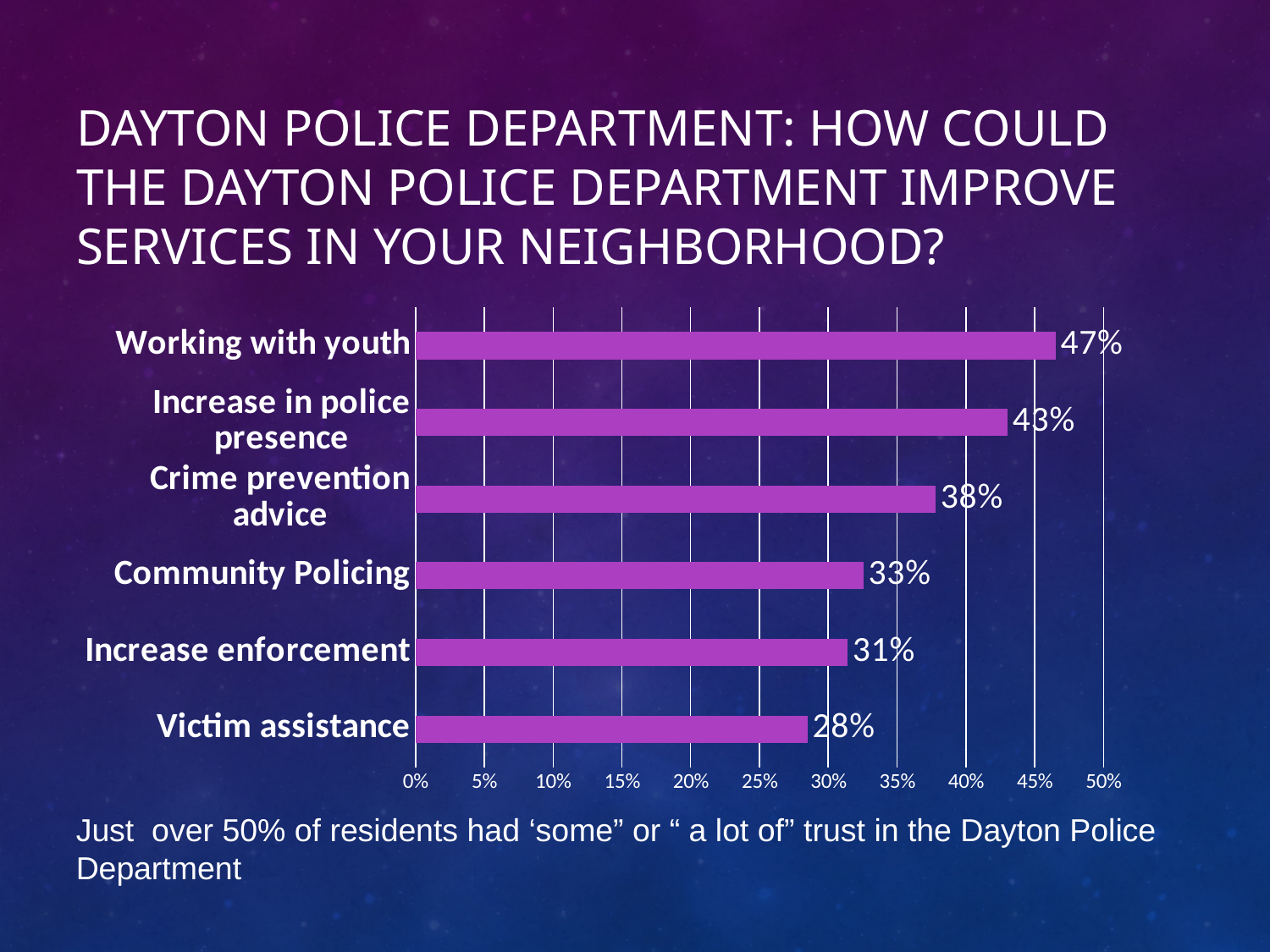
What is the value for 'Crime prevention advice'? 38% What kind of chart is shown on the slide? Bar chart What is the maximum value shown on the horizontal axis? 50% Which category has the lowest value? Victim assistance What is the value for 'Victim assistance'? 28% What percentage of respondents chose 'Working with youth'? 47% Which category has the highest value? Working with youth What is the difference between 'Increase in police presence' and 'Community Policing'? 10% What is the value for 'Increase enforcement'? 31% Which is larger, 'Crime prevention advice' or 'Community Policing'? Crime prevention advice How many categories are shown in the chart? 6 What is the difference between 'Working with youth' and 'Victim assistance'? 19%